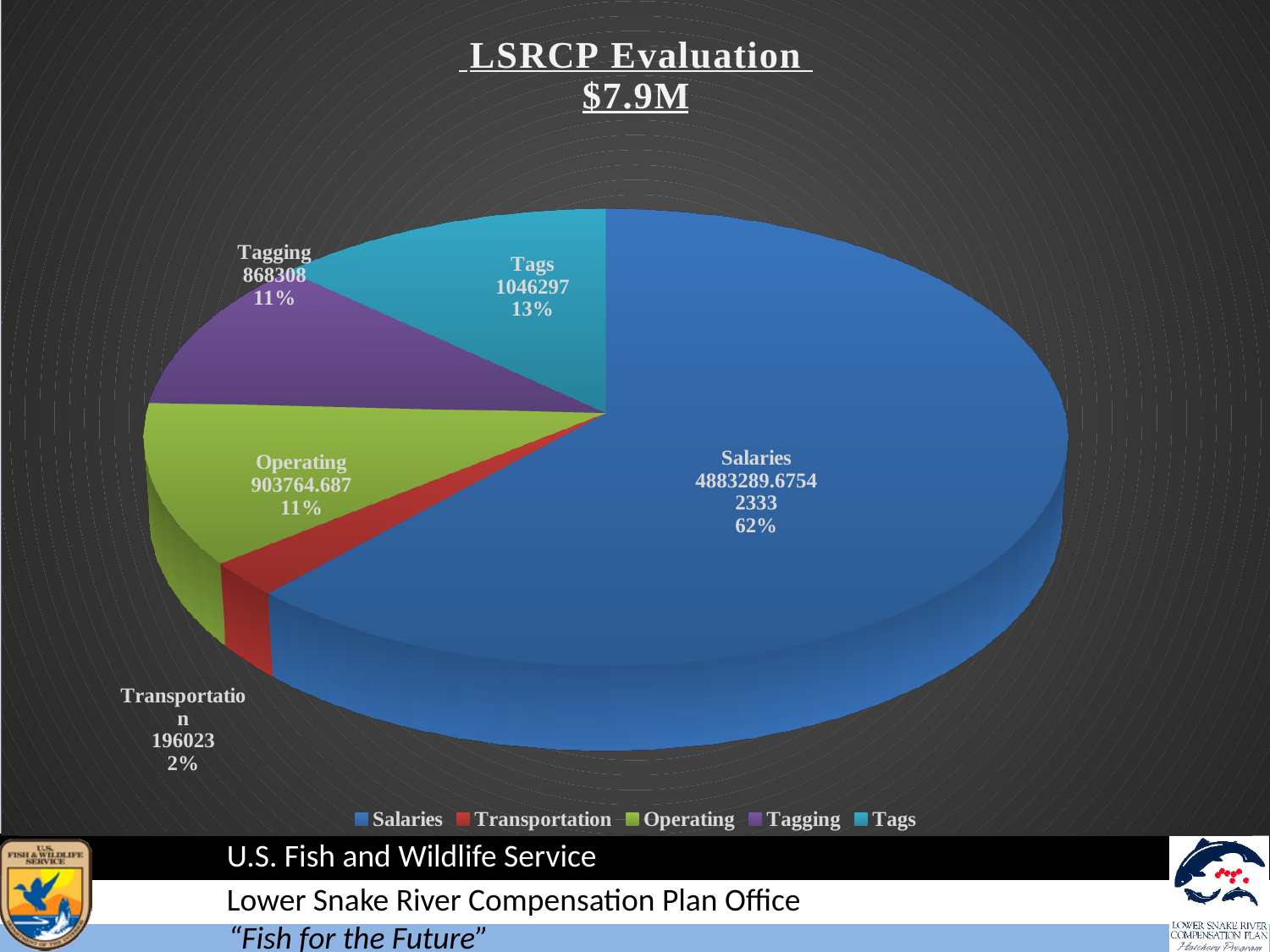
Which category has the largest slice? Salaries How many entries does the legend list? 5 What share of the pie does Salaries account for? 62% What is the value shown for Operating? 903764.687 Which category has the smallest slice? Transportation What is the value shown for Transportation? 196023 What is the value shown for Tags? 1046297 What is the difference between the Tags value and the Tagging value? 177989 How many slices does the pie chart have? 5 What share of the pie does Tags account for? 13% What kind of chart is shown on the slide? Pie chart Which is larger, Tags or Tagging? Tags